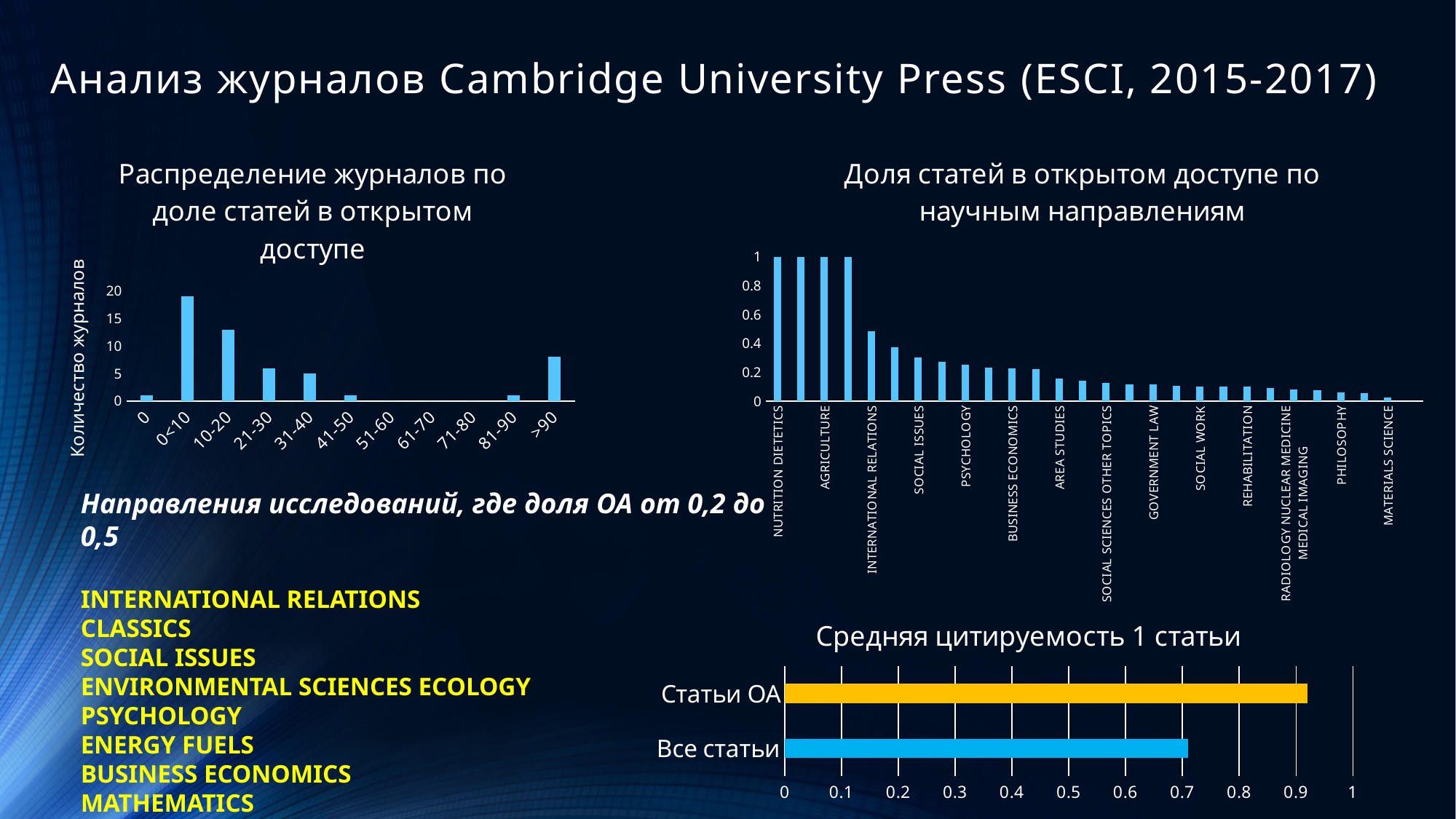
In the chart "Доля статей в открытом доступе по научным направлениям", is the value for INTERNATIONAL RELATIONS greater or less than 0.4? greater In the chart "Доля статей в открытом доступе по научным направлениям", do the values rise or fall from left to right along the x axis? fall In the chart "Распределение журналов по доле статей в открытом доступе", how many categories are shown on the x axis? 11 In the chart "Распределение журналов по доле статей в открытом доступе", which is larger: the value for 21-30 or the value for >90? >90 In the chart "Распределение журналов по доле статей в открытом доступе", what is the y-axis title? Количество журналов In the chart "Распределение журналов по доле статей в открытом доступе", is the value for 10-20 greater or less than 10? greater In the chart "Распределение журналов по доле статей в открытом доступе", which category has the highest number of journals? 0<10 What type of chart is "Распределение журналов по доле статей в открытом доступе"? bar chart In the chart "Доля статей в открытом доступе по научным направлениям", what is the value for NUTRITION DIETETICS? 1 In the chart "Распределение журналов по доле статей в открытом доступе", is the value for >90 greater or less than 10? less In the chart "Средняя цитируемость 1 статьи", which is larger: Статьи ОА or Все статьи? Статьи ОА